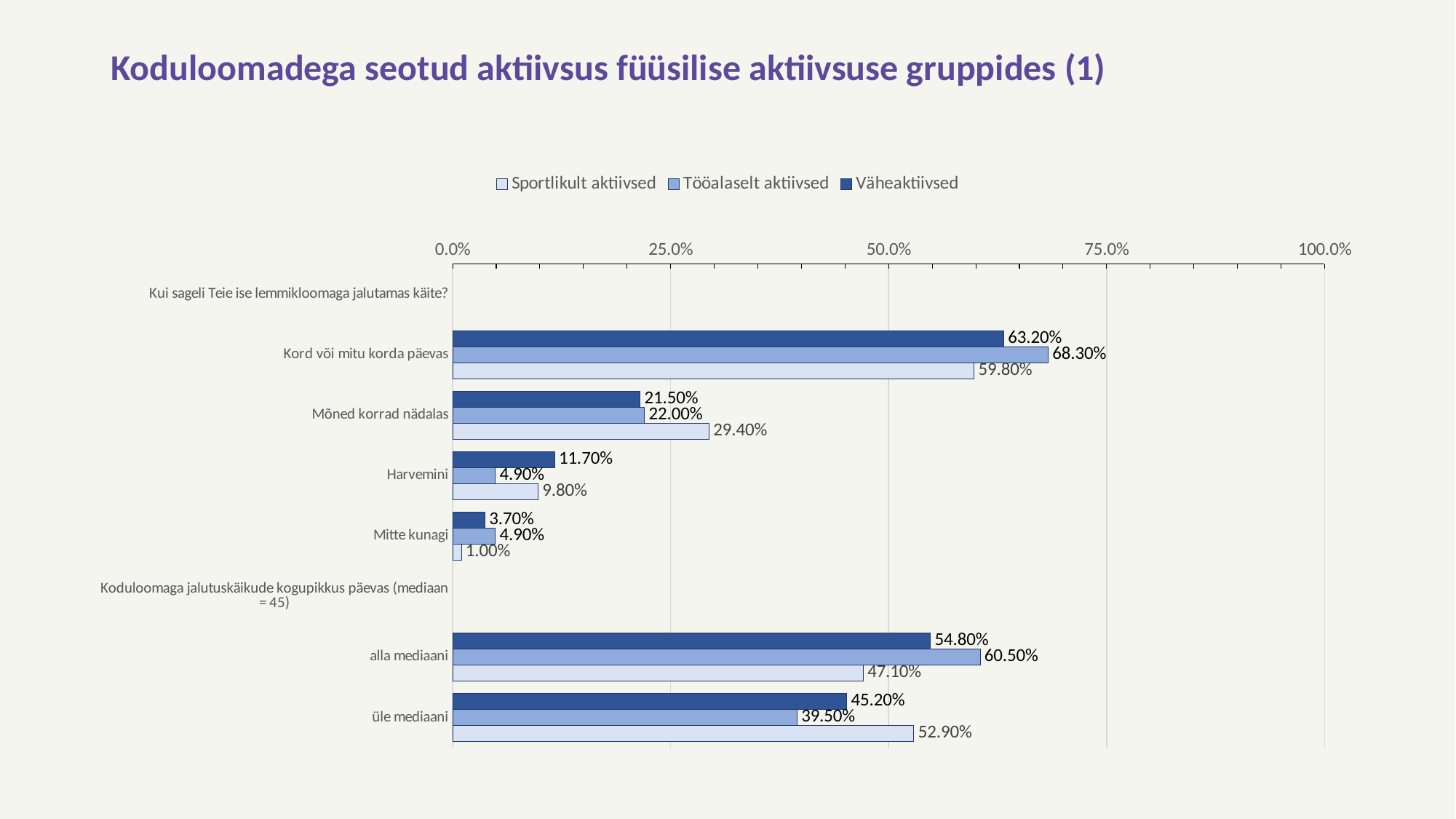
What is the difference between the Väheaktiivsed and Sportlikult aktiivsed values in the category "alla mediaani"? 7.70% What is the value for Väheaktiivsed in the category "Harvemini"? 11.70% What is the title of the slide? Koduloomadega seotud aktiivsus füüsilise aktiivsuse gruppides (1) Which series has the highest value in the category "alla mediaani"? Tööalaselt aktiivsed Is the value for Sportlikult aktiivsed in "Kord või mitu korda päevas" greater or less than 50.0%? greater What kind of chart is shown on the slide? Bar chart What is the value for Sportlikult aktiivsed in the category "Mitte kunagi"? 1.00% What is the value for Tööalaselt aktiivsed in the category "Kord või mitu korda päevas"? 68.30% How many series does the legend list? 3 What is the value for Sportlikult aktiivsed in the category "Mõned korrad nädalas"? 29.40% Which is larger in the category "Harvemini": the value for Sportlikult aktiivsed or for Tööalaselt aktiivsed? Sportlikult aktiivsed Which series has the lowest value in the category "üle mediaani"? Tööalaselt aktiivsed